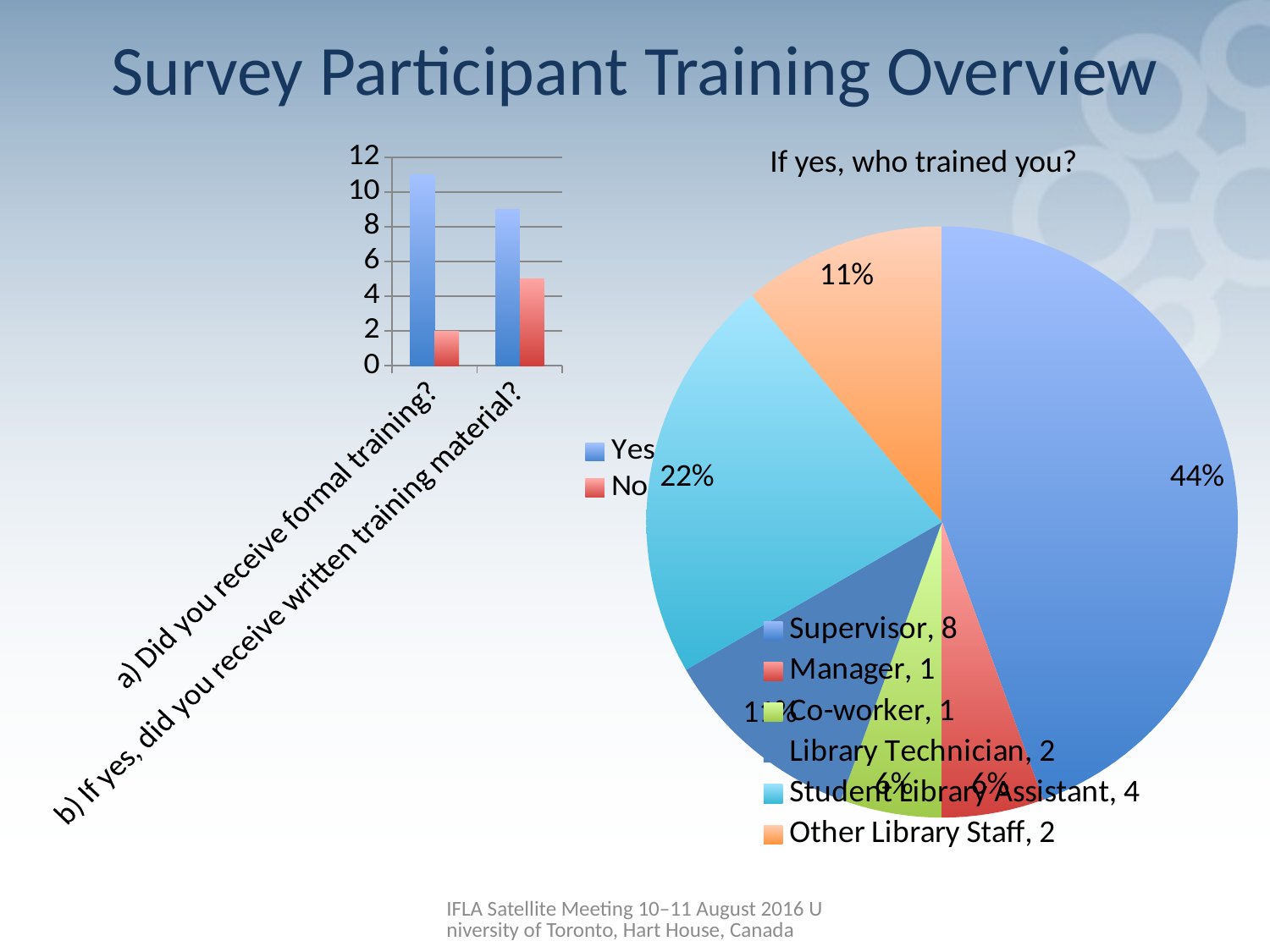
In the bar chart on the left, for "b) If yes, did you receive written training material?", which is larger, Yes or No? Yes In the pie chart "If yes, who trained you?", what is the difference between the Supervisor count and the Student Library Assistant count? 4 In the pie chart "If yes, who trained you?", what share of the pie does Student Library Assistant represent? 22% In the pie chart "If yes, who trained you?", how many participants were trained by a Student Library Assistant? 4 In the pie chart "If yes, who trained you?", what share of the pie does Supervisor represent? 44% In the pie chart "If yes, who trained you?", how many categories are shown in the legend? 6 What kind of chart is the chart titled "If yes, who trained you?"? pie chart In the pie chart "If yes, who trained you?", how many participants were trained by a Supervisor? 8 In the bar chart on the left, how many series does the legend list? 2 In the pie chart "If yes, who trained you?", which category has the largest slice? Supervisor In the bar chart on the left, is the Yes value for "a) Did you receive formal training?" greater or less than 10? greater What kind of chart is the chart on the left of the slide? bar chart